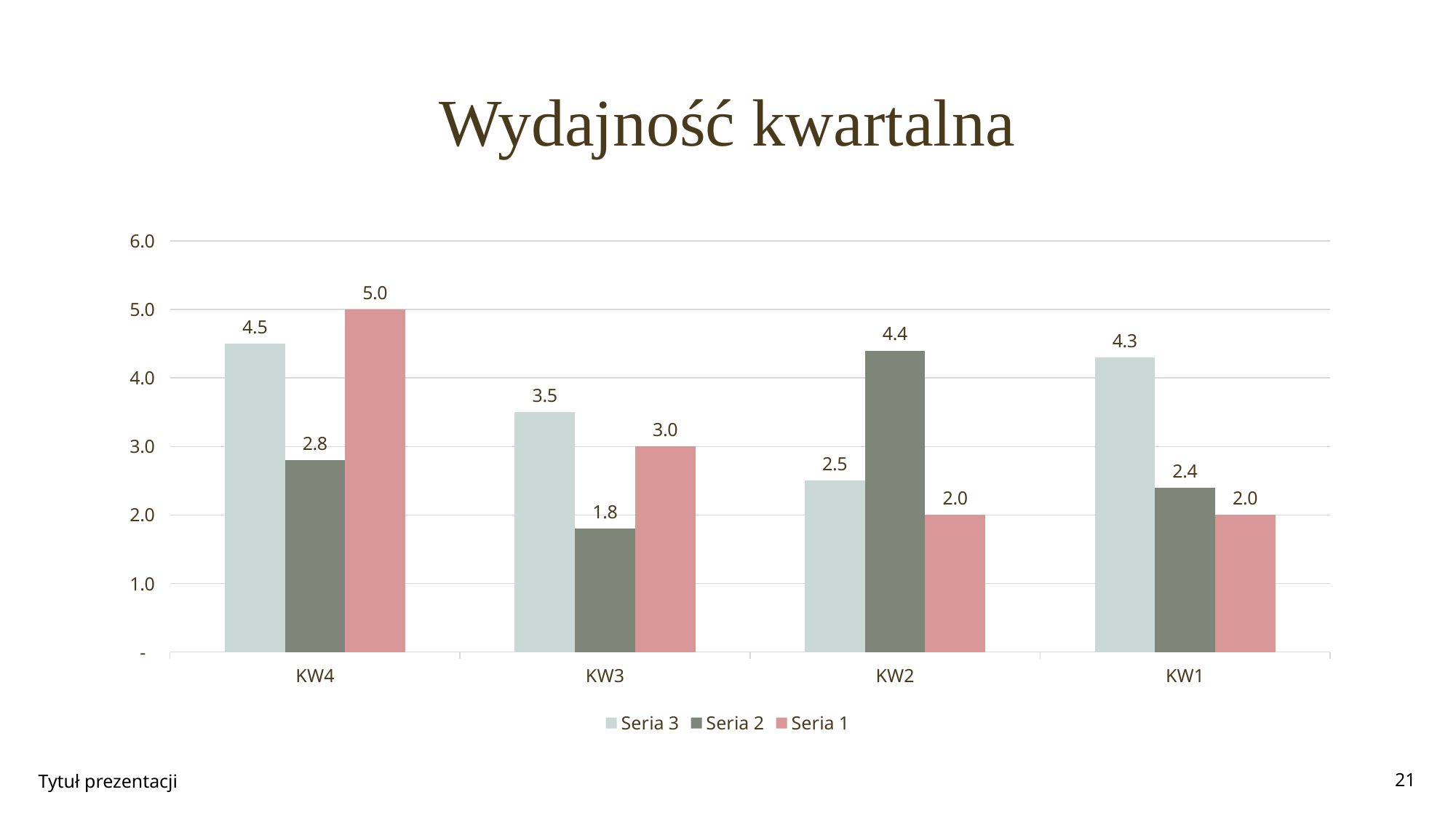
What is the value of Seria 2 for KW3? 1.8 Which category has the lowest value for Seria 3? KW2 What is the value of Seria 1 for KW4? 5.0 What is the title of the chart? Wydajność kwartalna How many series does the legend list? 3 How many categories are shown on the x axis? 4 What is the difference between Seria 1 and Seria 2 for KW4? 2.2 Is the value of Seria 2 for KW2 greater or less than 4.0? greater What is the value of Seria 3 for KW1? 4.3 Which is larger for KW3: Seria 3 or Seria 1? Seria 3 Which category has the highest value for Seria 2? KW2 What kind of chart is shown on the slide? Bar chart